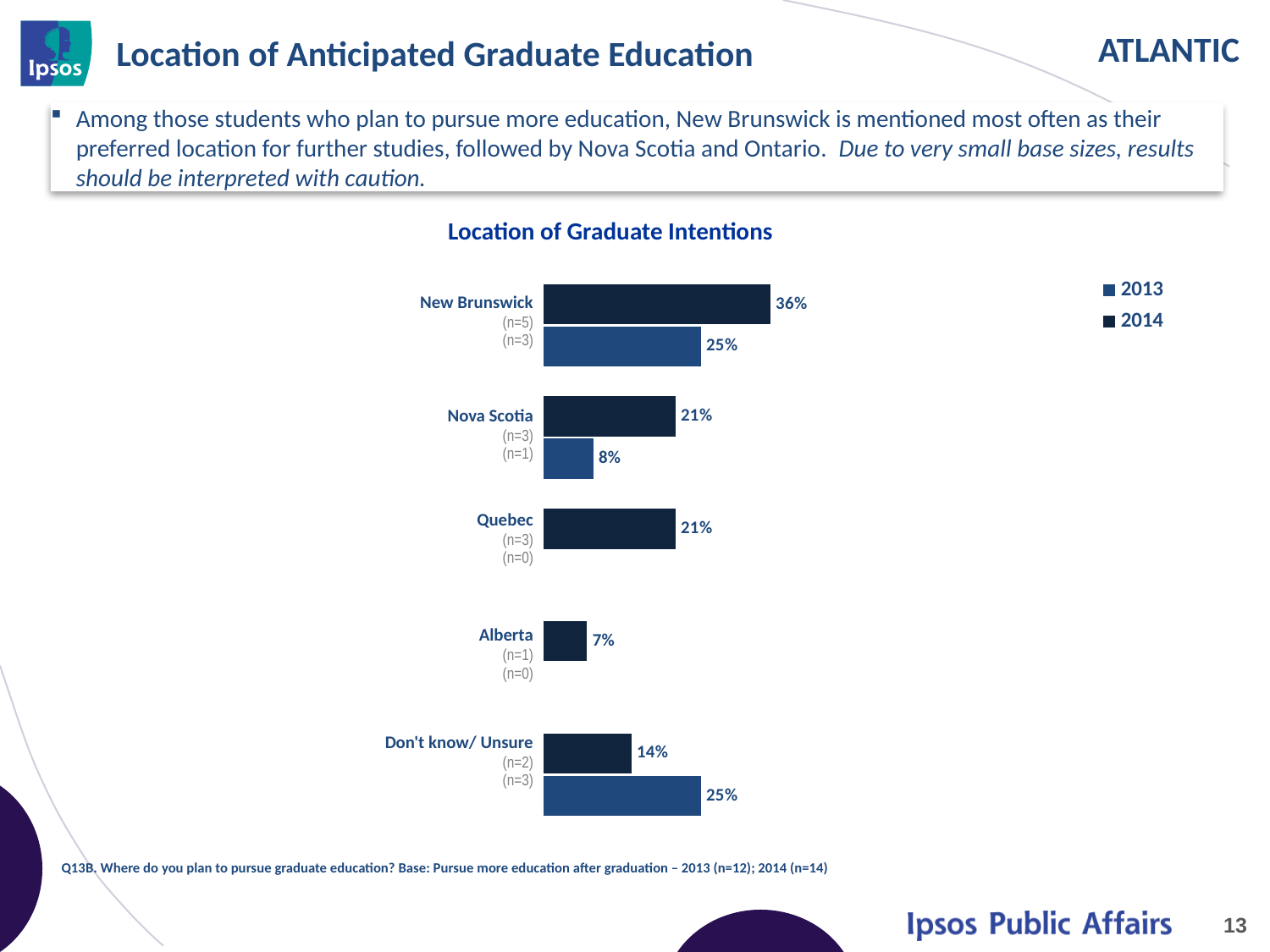
What is the difference between the 2014 and 2013 values for New Brunswick? 11 percentage points What is the 2014 value for Alberta? 7% What kind of chart is shown on the slide? Bar chart How many series does the legend list in the Location of Graduate Intentions chart? 2 What is the 2013 value for New Brunswick? 25% Which location has the highest 2014 value? New Brunswick What is the 2013 value for Nova Scotia? 8% What is the 2013 value for Don't know/ Unsure? 25% How many location categories are shown in the Location of Graduate Intentions chart? 5 What is the title of the chart? Location of Graduate Intentions What is the 2014 value for New Brunswick? 36% For Don't know/ Unsure, which year has the larger value, 2013 or 2014? 2013